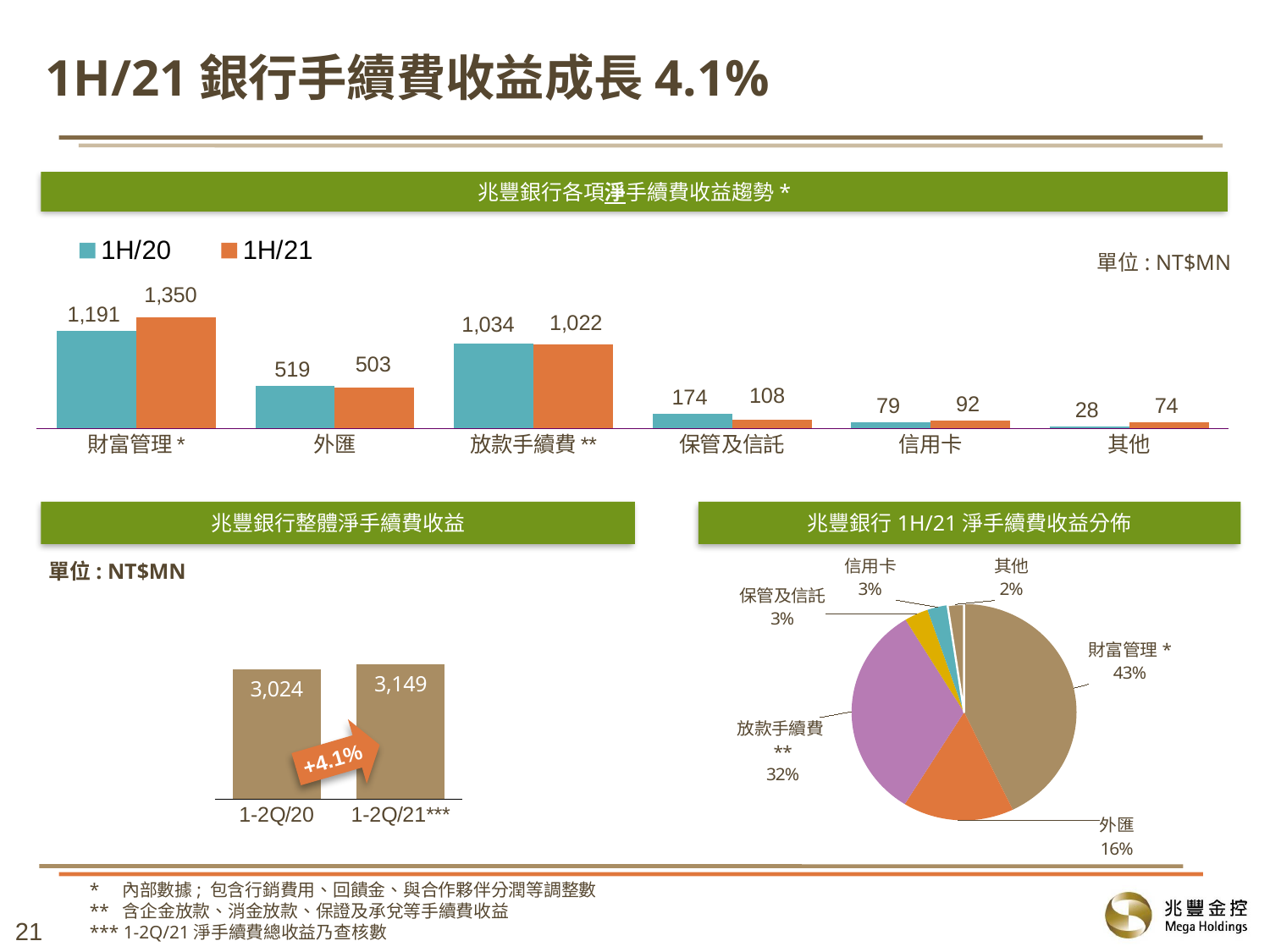
In the bottom-left chart (兆豐銀行整體淨手續費收益), what is the difference between the 1-2Q/21*** and 1-2Q/20 values? 125 In the top chart (兆豐銀行各項淨手續費收益趨勢), is the 1H/20 or the 1H/21 value larger for 外匯? 1H/20 In the bottom-right pie chart (兆豐銀行 1H/21 淨手續費收益分佈), what share does 放款手續費 ** have? 32% In the top chart (兆豐銀行各項淨手續費收益趨勢), how many categories are shown on the x axis? 6 In the bottom-right pie chart (兆豐銀行 1H/21 淨手續費收益分佈), which slice is the largest? 財富管理 * In the top chart (兆豐銀行各項淨手續費收益趨勢), what is the 1H/21 value for 財富管理 *? 1,350 In the top chart (兆豐銀行各項淨手續費收益趨勢), which category has the lowest 1H/20 value? 其他 What kind of chart is the bottom-right chart (兆豐銀行 1H/21 淨手續費收益分佈)? Pie chart In the top chart (兆豐銀行各項淨手續費收益趨勢), what is the 1H/20 value for 保管及信託? 174 In the top chart (兆豐銀行各項淨手續費收益趨勢), how many series does the legend list? 2 In the top chart (兆豐銀行各項淨手續費收益趨勢), what is the difference between the 1H/21 and 1H/20 values for 財富管理 *? 159 In the bottom-left chart (兆豐銀行整體淨手續費收益), what is the value for 1-2Q/21***? 3,149